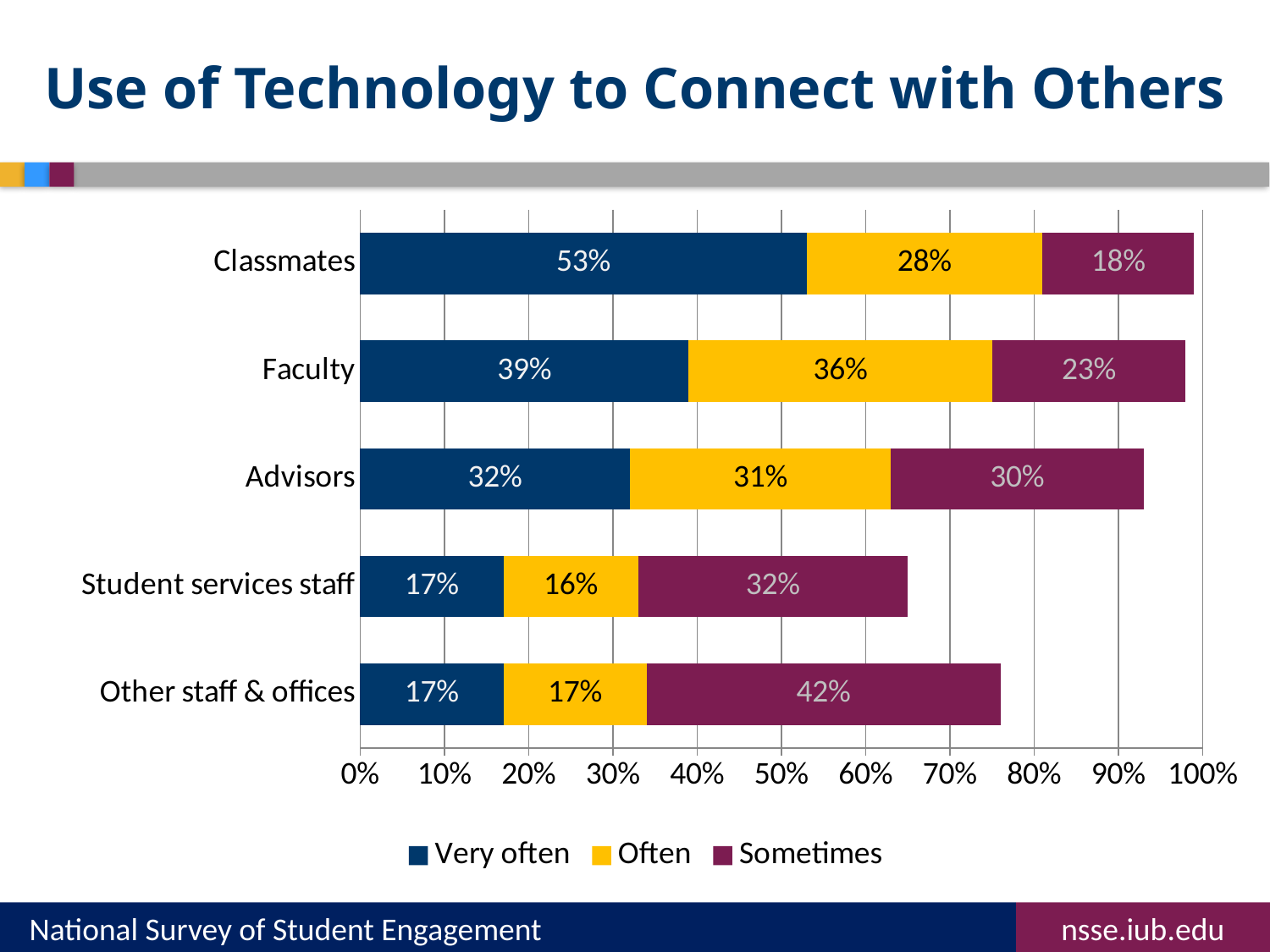
What is the 'Often' value for Faculty? 36% What is the total of the stacked bar for Student services staff? 65% Which category has the lowest 'Often' value? Student services staff Which category has the highest 'Very often' value? Classmates What is the 'Sometimes' value for Other staff & offices? 42% What percentage of students reported using technology 'Very often' to connect with Classmates? 53% What is the difference between the 'Very often' values for Classmates and Faculty? 14% What is the total of the stacked bar for Classmates? 99% Which is larger: the 'Sometimes' value for Advisors or the 'Sometimes' value for Faculty? Advisors What type of chart is shown on the slide? Stacked bar chart How many categories are shown on the chart? 5 How many series does the legend list? 3